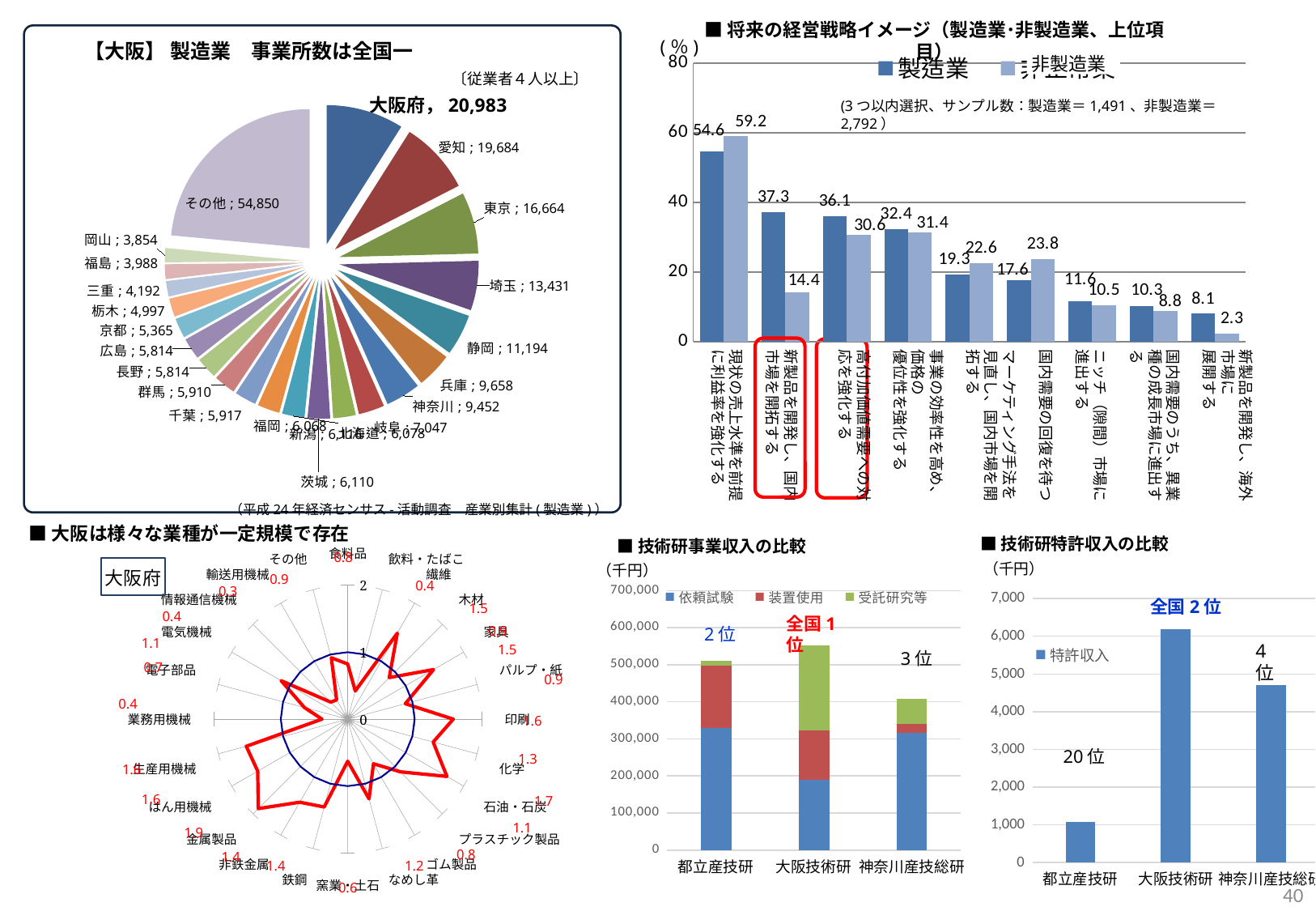
In the pie chart titled 【大阪】製造業 事業所数は全国一, what is the value for 大阪府? 20,983 In the bar chart titled 将来の経営戦略イメージ, how many categories are shown on the x axis? 9 In the chart titled 技術研事業収入の比較, what kind of chart is it? stacked bar chart In the chart titled 技術研特許収入の比較, which institution has the highest value? 大阪技術研 In the radar chart titled 大阪は様々な業種が一定規模で存在, what is the value for 化学? 1.3 In the pie chart titled 【大阪】製造業 事業所数は全国一, what is the value for 東京? 16,664 In the pie chart titled 【大阪】製造業 事業所数は全国一, what is the difference between 大阪府 and 愛知? 1,299 In the bar chart titled 将来の経営戦略イメージ, what is the 製造業 value for 新製品を開発し、国内市場を開拓する? 37.3 In the bar chart titled 将来の経営戦略イメージ, which category has the highest 製造業 value? 現状の売上水準を前提に利益率を強化する In the chart titled 技術研事業収入の比較, is the total for 神奈川産技総研 greater or less than 500,000? less In the bar chart titled 将来の経営戦略イメージ, how many series does the legend list? 2 In the bar chart titled 将来の経営戦略イメージ, what is the 非製造業 value for 国内需要の回復を待つ? 23.8